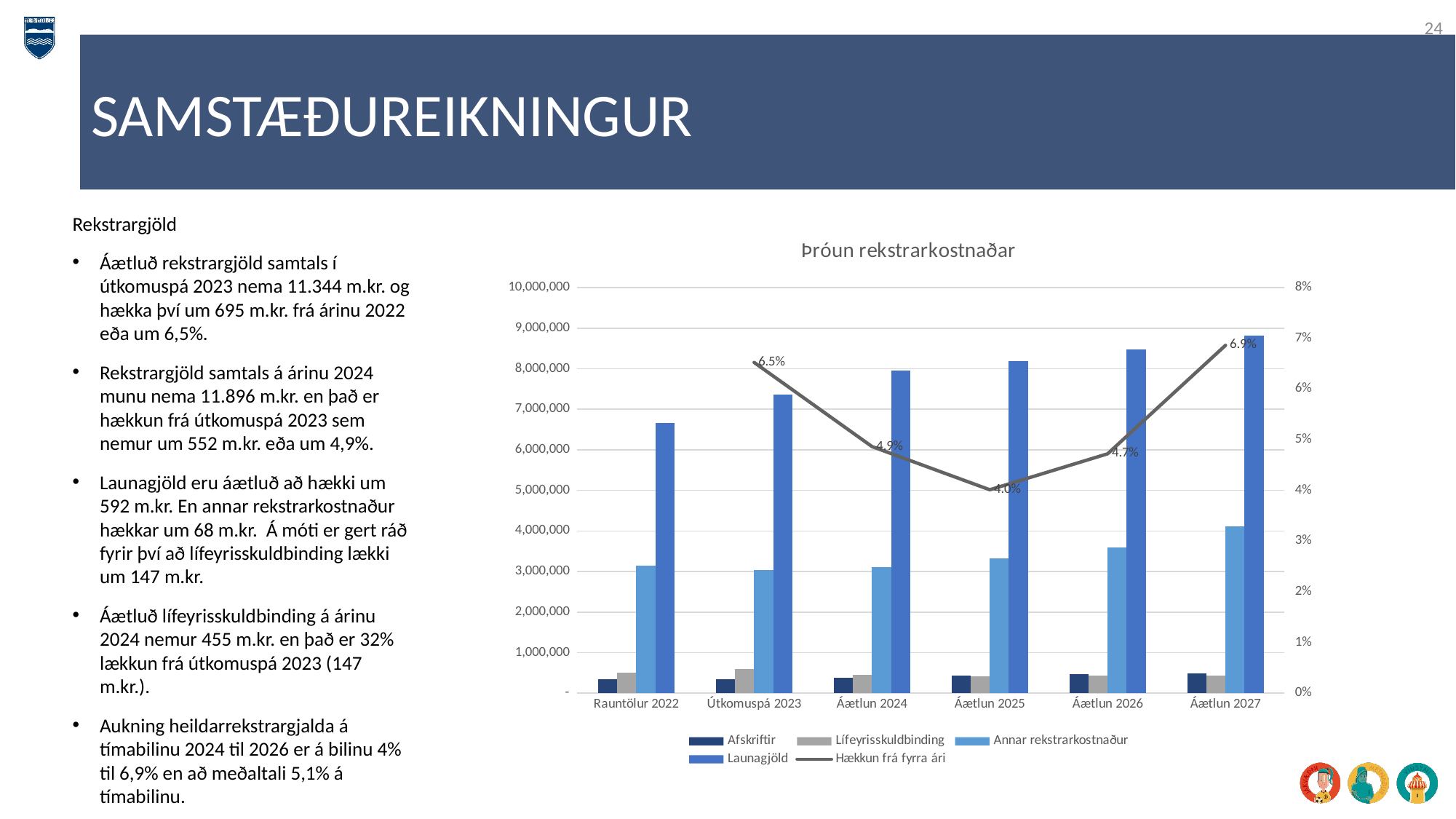
What is the value of Hækkun frá fyrra ári for Útkomuspá 2023? 6.5% Which category has the highest value of Hækkun frá fyrra ári? Áætlun 2027 How many series does the chart's legend list? 5 What is the value of Hækkun frá fyrra ári for Áætlun 2027? 6.9% What is the difference between the Hækkun frá fyrra ári values for Útkomuspá 2023 and Áætlun 2024? 1.6 percentage points What kind of chart is shown on the slide? Bar chart with a line How many categories are shown on the x axis of the chart? 6 Is the Launagjöld value for Áætlun 2027 greater or less than 8,000,000? greater What is the value of Hækkun frá fyrra ári for Áætlun 2025? 4.0% Which category has the lowest value of Hækkun frá fyrra ári? Áætlun 2025 What is the title of the chart? Þróun rekstrarkostnaðar Do the Launagjöld values rise or fall from Rauntölur 2022 to Áætlun 2027? rise